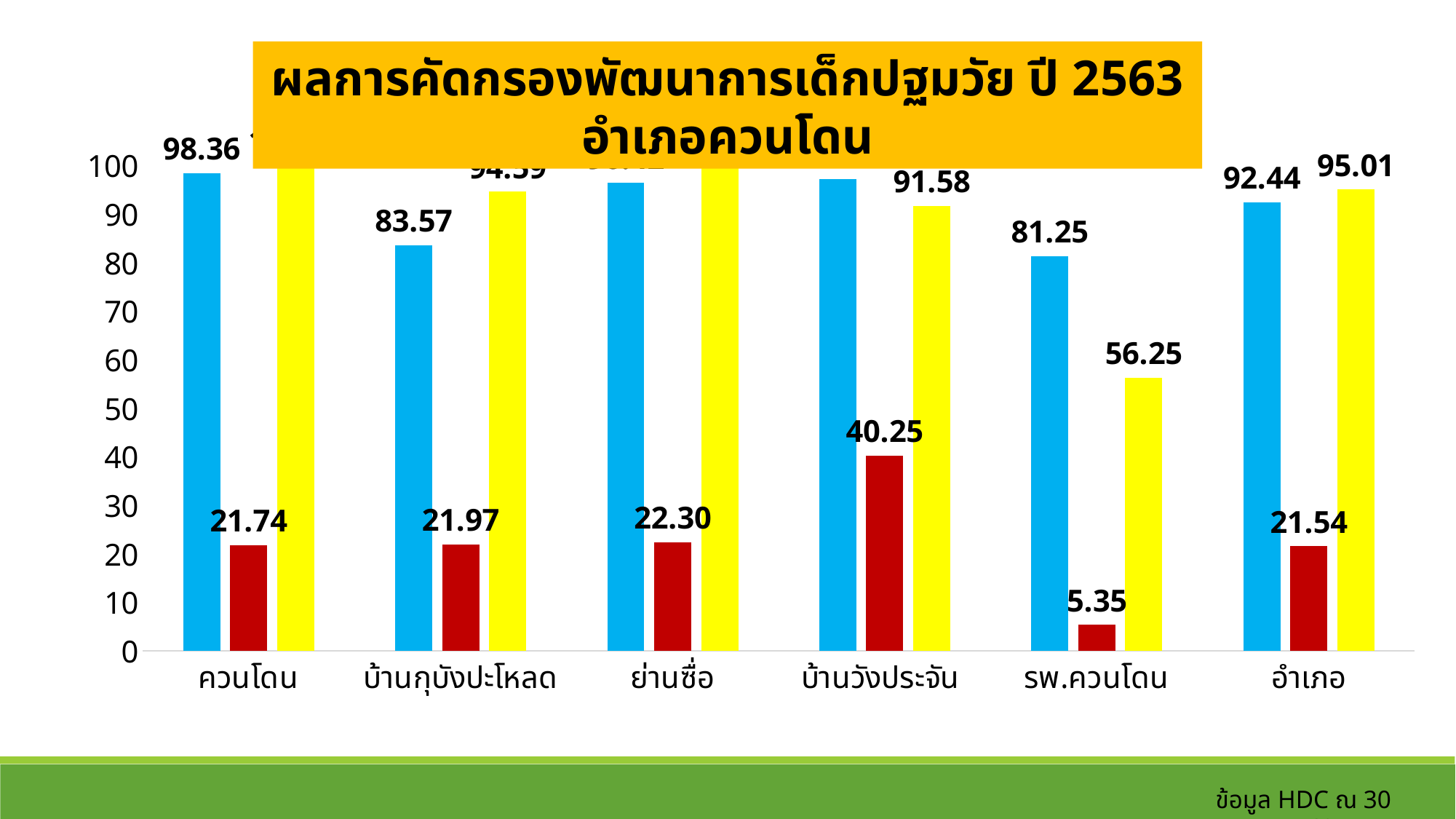
What is the value of the yellow bar for อำเภอ? 95.01 What is the value of the red bar for บ้านวังประจัน? 40.25 Is the value of the blue bar for ย่านซื่อ greater or less than 90? greater What is the difference between the red bar for บ้านกุบังปะโหลด and the red bar for ควนโดน? 0.23 What is the value of the blue bar for ควนโดน? 98.36 What kind of chart is shown on the slide? bar chart What is the value of the yellow bar for รพ.ควนโดน? 56.25 How many categories are shown on the x axis? 6 Which category has the lowest blue bar? รพ.ควนโดน Which is larger: the blue bar for ควนโดน or the blue bar for อำเภอ? ควนโดน Which category has the highest red bar? บ้านวังประจัน What is the value of the red bar for รพ.ควนโดน? 5.35